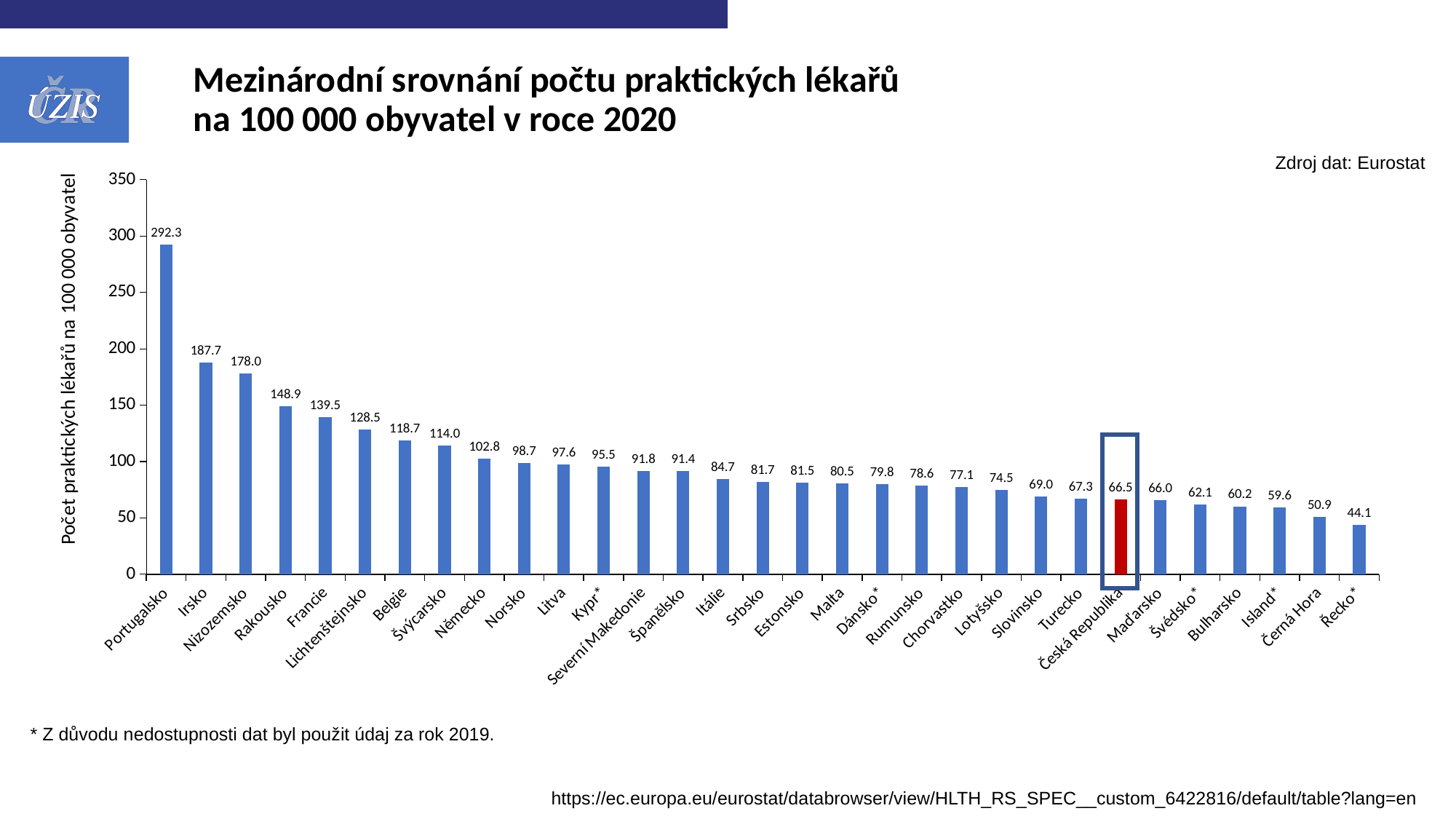
What is the value for Německo? 102.8 What is the value for Česká Republika? 66.5 Which country has the highest value? Portugalsko What is the value for Slovinsko? 69.0 Which country has the lowest value? Řecko What is the difference between the values for Česká Republika and Řecko? 22.4 Is the value for Belgie greater or less than 100? greater How many countries are shown on the chart? 31 Which has a larger value, Rakousko or Francie? Rakousko What is the difference between the values for Portugalsko and Irsko? 104.6 What kind of chart is shown on the slide? bar chart Do the values rise or fall from left to right along the x axis? fall